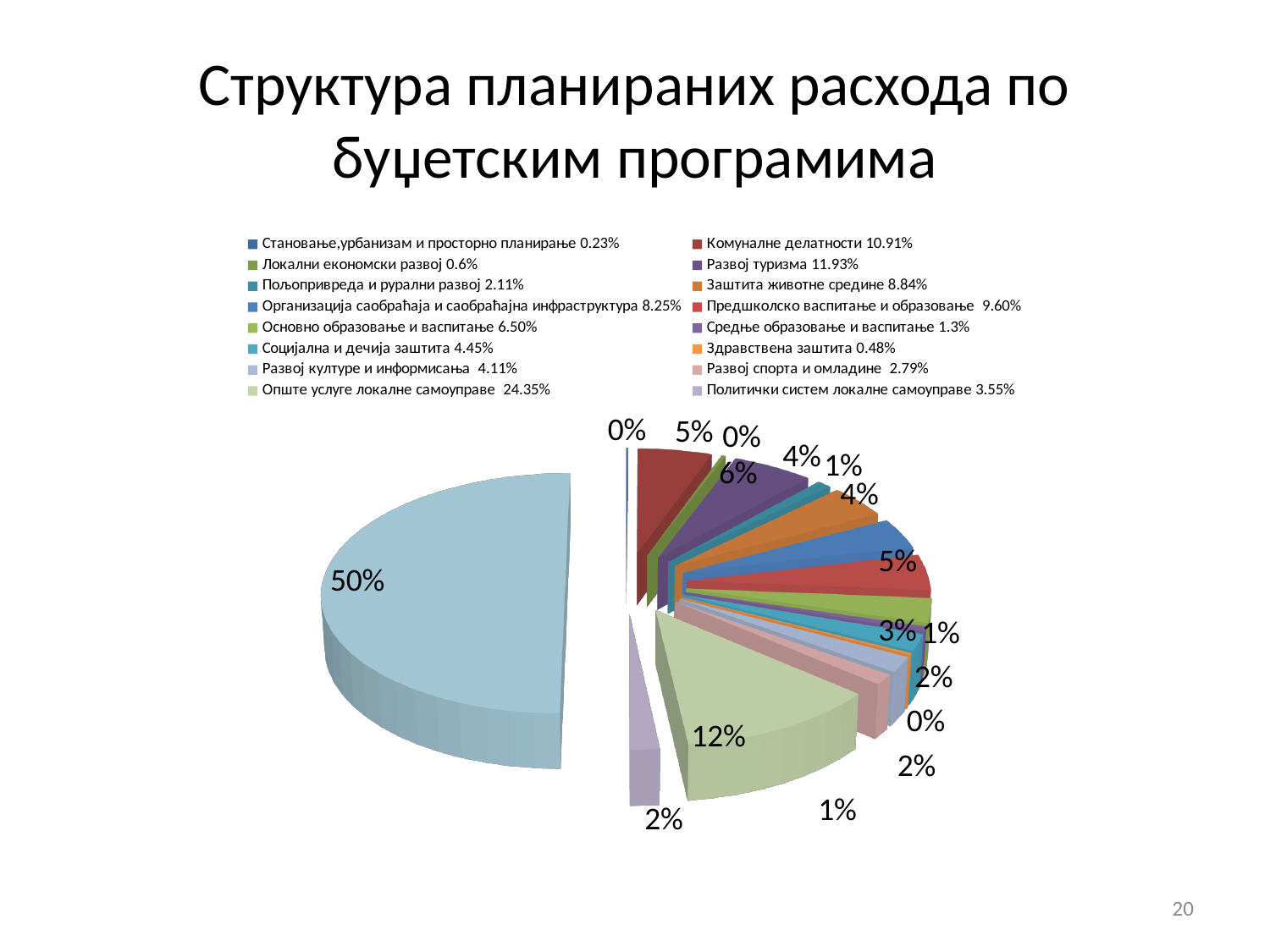
According to the legend, what percentage is given for Развој туризма? 11.93% Which has a larger percentage in the legend, Развој туризма or Комуналне делатности? Развој туризма How many entries does the chart legend list? 16 According to the legend, what percentage is given for Опште услуге локалне самоуправе? 24.35% Which legend entry has the highest percentage? Опште услуге локалне самоуправе What is the title of the slide containing the chart? Структура планираних расхода по буџетским програмима Which legend entry has the lowest percentage? Становање,урбанизам и просторно планирање What type of chart is shown on the slide? pie chart What is the largest percentage data label printed on the pie? 50% According to the legend, what percentage is given for Предшколско васпитање и образовање? 9.60% According to the legend, what percentage is given for Комуналне делатности? 10.91% What is the difference between the legend percentages for Заштита животне средине and Организација саобраћаја и саобраћајна инфраструктура? 0.59%